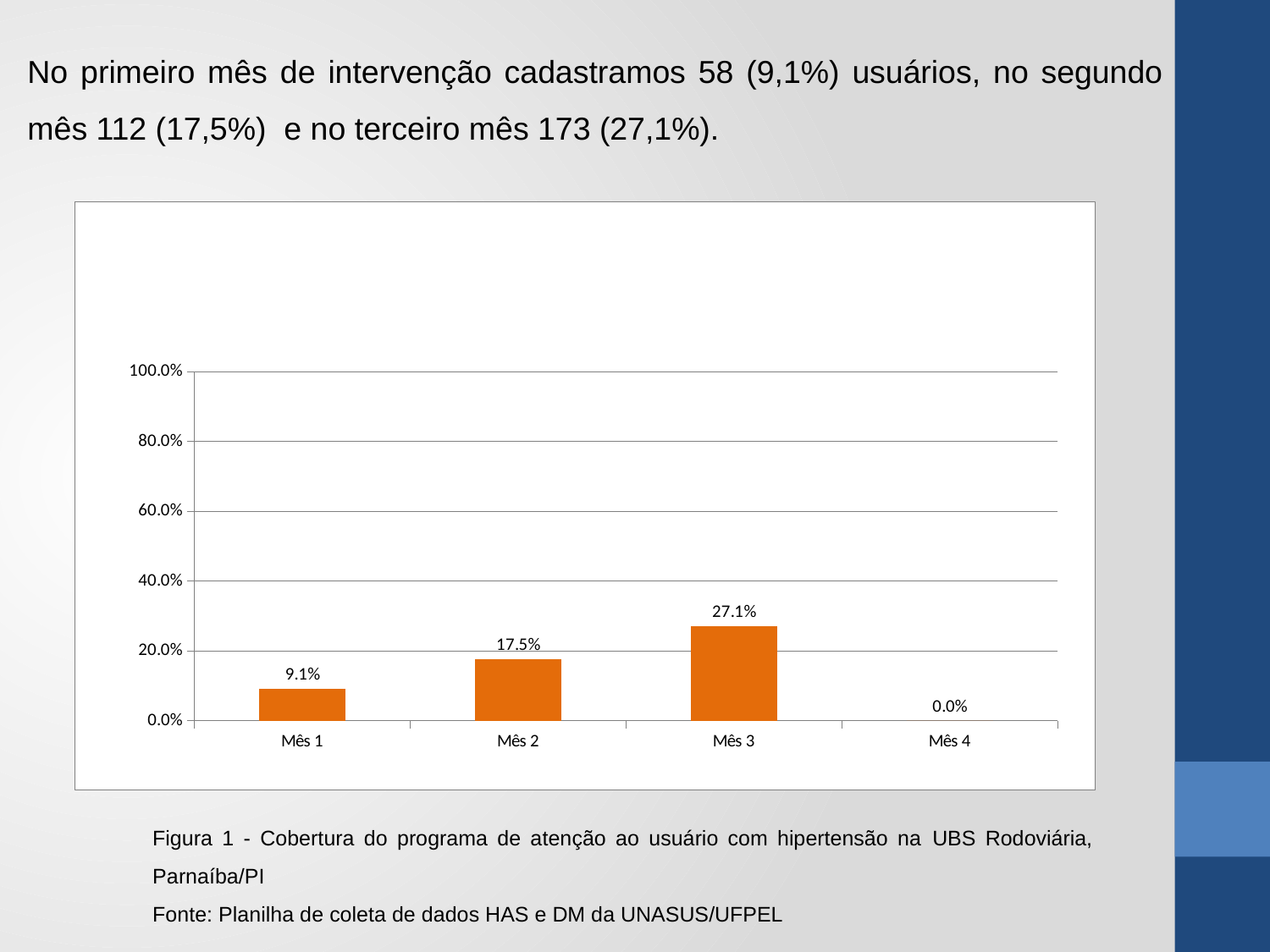
What is the value for Mês 1? 9.1% Which is larger, the value for Mês 2 or the value for Mês 3? Mês 3 What kind of chart is shown on the slide? bar chart What is the value for Mês 4? 0.0% What is the difference between the values for Mês 2 and Mês 1? 8.4% What is the value for Mês 3? 27.1% How many categories are shown on the x axis? 4 Which month has the lowest value? Mês 4 Is the value for Mês 3 greater or less than 20.0%? greater Which month has the highest value? Mês 3 What is the value for Mês 2? 17.5% What is the difference between the values for Mês 3 and Mês 1? 18.0%